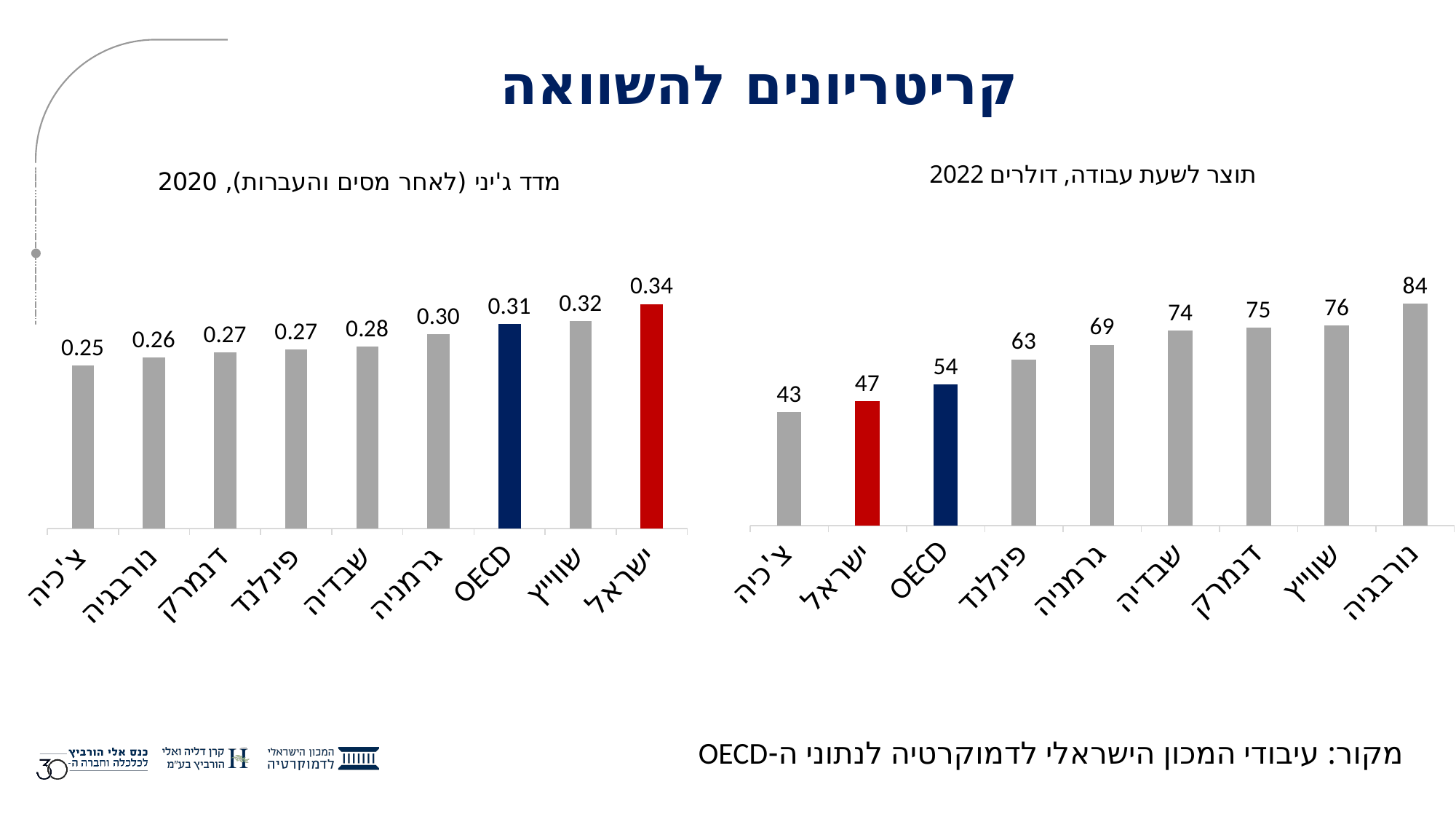
In the right-hand chart (תוצר לשעת עבודה, דולרים 2022), what is the value for Israel (ישראל)? 47 In the right-hand chart (תוצר לשעת עבודה, דולרים 2022), what is the difference between Norway (נורבגיה) and Israel (ישראל)? 37 In the right-hand chart (תוצר לשעת עבודה, דולרים 2022), which country has the highest value? נורבגיה (Norway) What type of chart is the right-hand chart (תוצר לשעת עבודה, דולרים 2022)? Bar chart How many countries/categories are shown in the left-hand chart (מדד ג'יני, 2020)? 9 What colour is the bar for Israel (ישראל) in both charts? Red In the left-hand chart (מדד ג'יני, 2020), what is the value for Israel (ישראל)? 0.34 In the right-hand chart (תוצר לשעת עבודה, דולרים 2022), which is larger: the value for Germany (גרמניה) or the OECD value? גרמניה (Germany) In the right-hand chart (תוצר לשעת עבודה, דולרים 2022), do the values rise or fall from left to right? Rise In the left-hand chart (מדד ג'יני, 2020), what is the OECD value? 0.31 In the left-hand chart (מדד ג'יני, 2020), what is the difference between Israel (ישראל) and the OECD value? 0.03 In the left-hand chart (מדד ג'יני, 2020), which country has the lowest value? צ'כיה (Czechia)